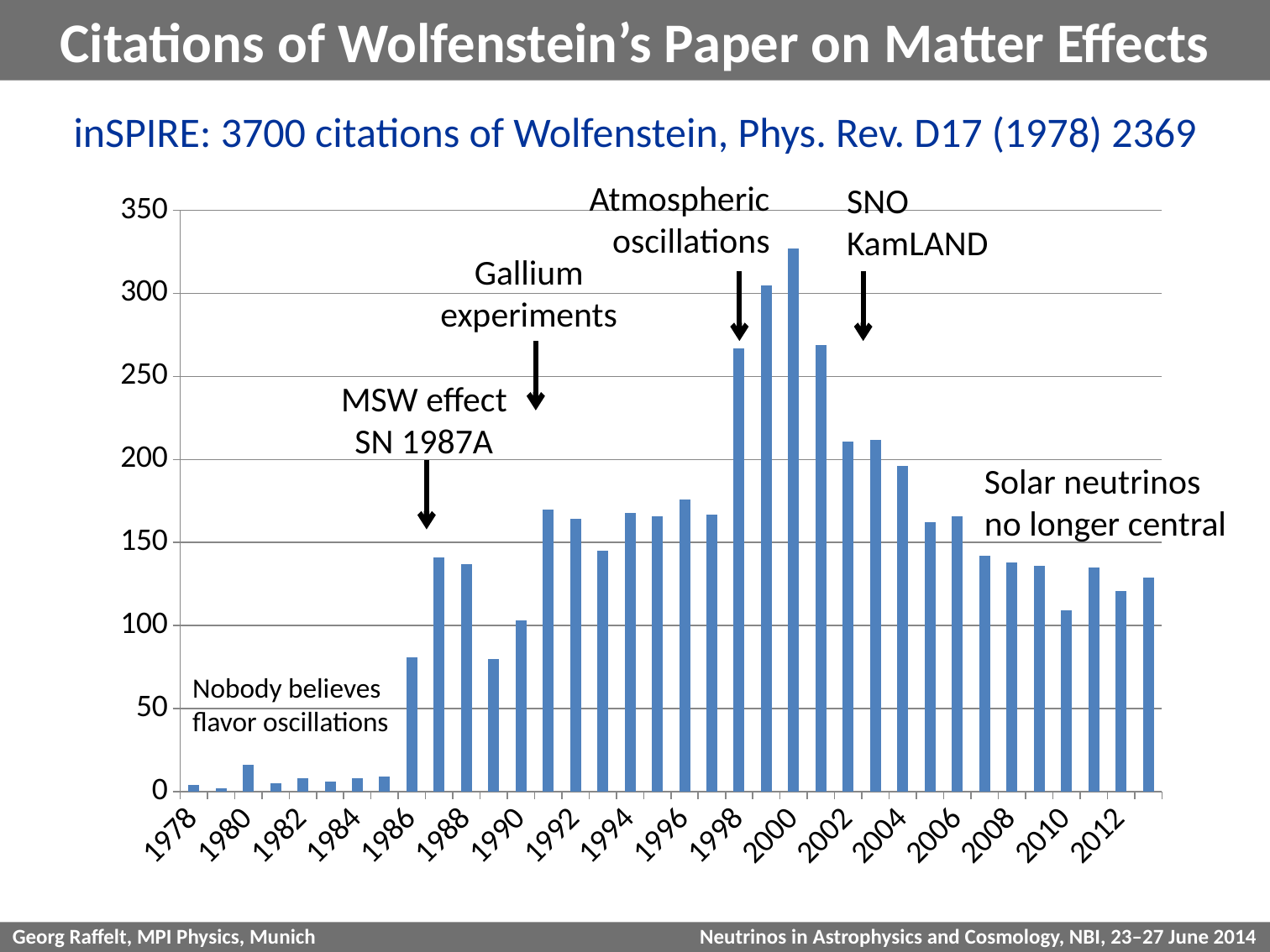
Do the citation counts rise or fall from 2000 to 2004? fall Which year has the lowest number of citations? 1979 Is the value for 1998 greater or less than 250? greater Is the value for 2012 greater or less than 150? less Is the value for 1986 greater or less than 50? greater What kind of chart is shown on the slide? bar chart Which year has more citations, 1998 or 2000? 2000 Which year has the highest number of citations? 2000 What is the title of the slide containing the chart? Citations of Wolfenstein's Paper on Matter Effects Which year has more citations, 1986 or 1987? 1987